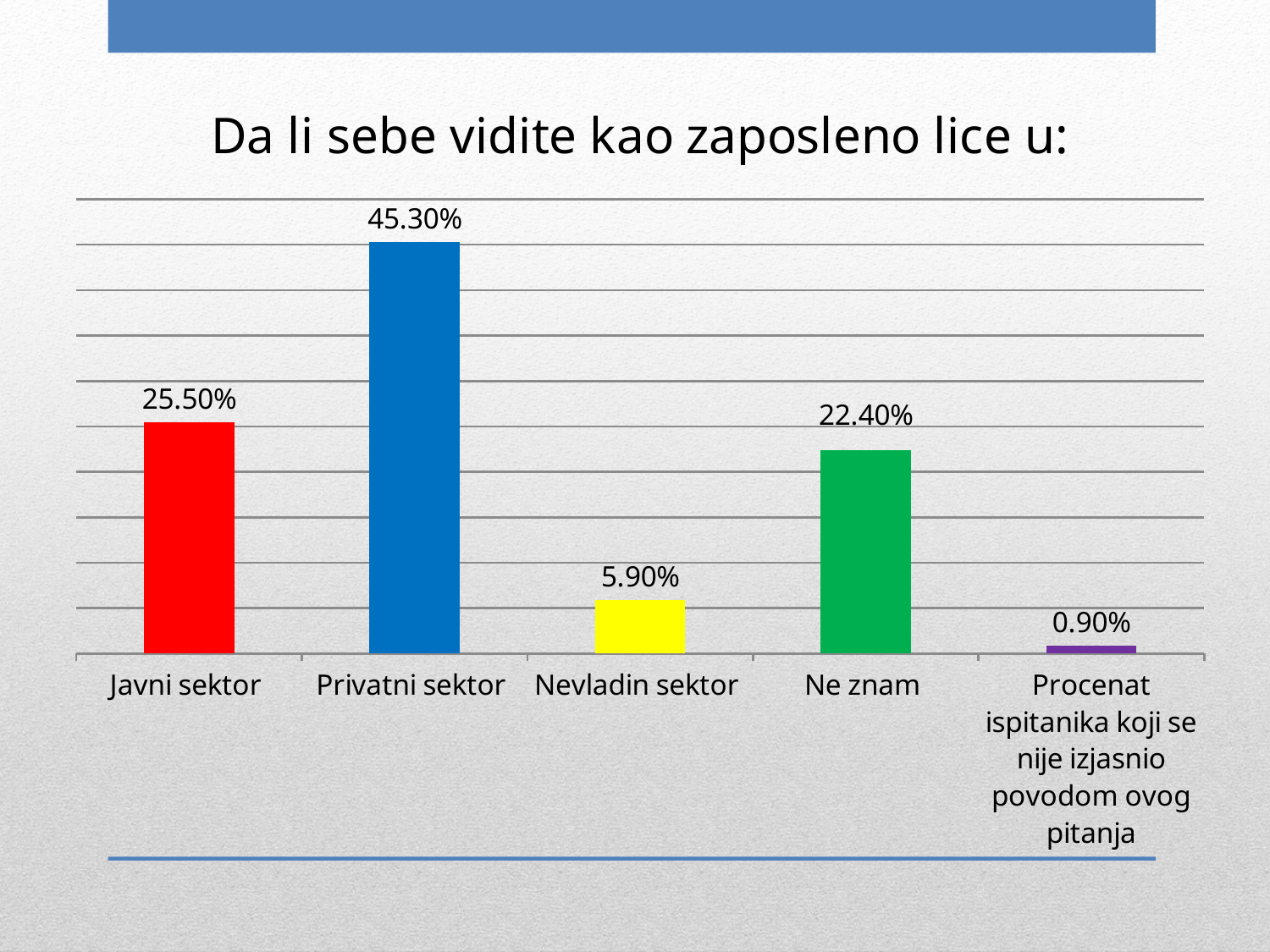
What is the title of the chart? Da li sebe vidite kao zaposleno lice u: What kind of chart is shown on the slide? Bar chart Which category has the highest value? Privatni sektor How many categories are shown in the chart? 5 Which category has the lowest value? Procenat ispitanika koji se nije izjasnio povodom ovog pitanja What is the value for Javni sektor? 25.50% What is the value for Privatni sektor? 45.30% What is the difference between the values for Privatni sektor and Javni sektor? 19.80% What is the difference between the values for Javni sektor and Ne znam? 3.10% What is the value for Nevladin sektor? 5.90% Which is larger, the value for Javni sektor or the value for Ne znam? Javni sektor What is the value for Ne znam? 22.40%